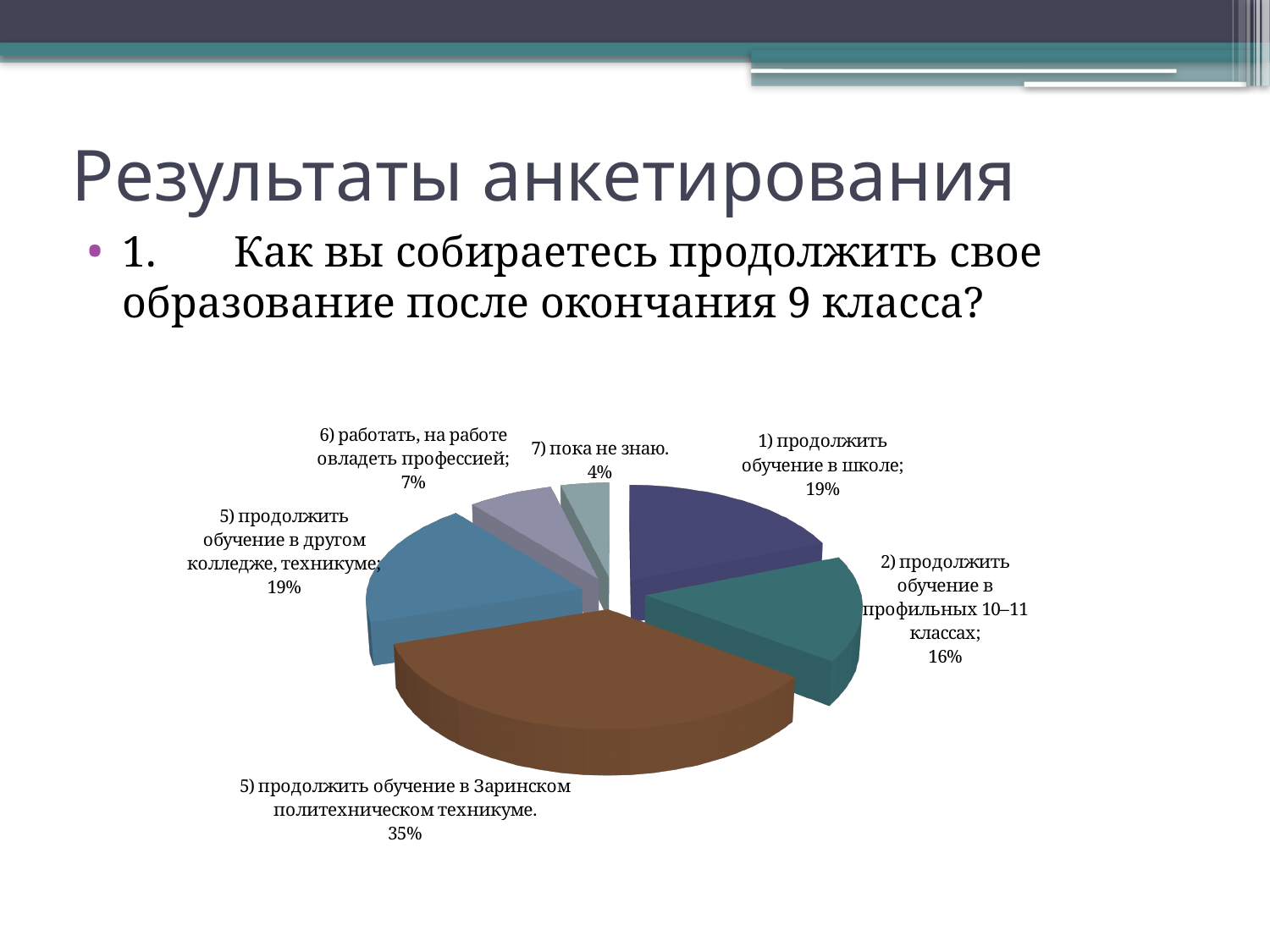
What percentage is shown for "продолжить обучение в школе"? 19% What percentage is shown for "продолжить обучение в профильных 10–11 классах"? 16% What kind of chart is shown on the slide? pie chart What survey question does the pie chart on the slide present results for? Как вы собираетесь продолжить свое образование после окончания 9 класса? Which slice of the pie chart is the largest? продолжить обучение в Заринском политехническом техникуме Which is larger: the share for "продолжить обучение в профильных 10–11 классах" or the share for "продолжить обучение в другом колледже, техникуме"? продолжить обучение в другом колледже, техникуме What percentage is shown for "работать, на работе овладеть профессией"? 7% How many slices does the pie chart have? 6 What share of the pie is labelled "продолжить обучение в Заринском политехническом техникуме"? 35% What is the difference in percentage points between "продолжить обучение в Заринском политехническом техникуме" and "продолжить обучение в школе"? 16 Which slice of the pie chart is the smallest? пока не знаю What percentage is shown for "пока не знаю"? 4%